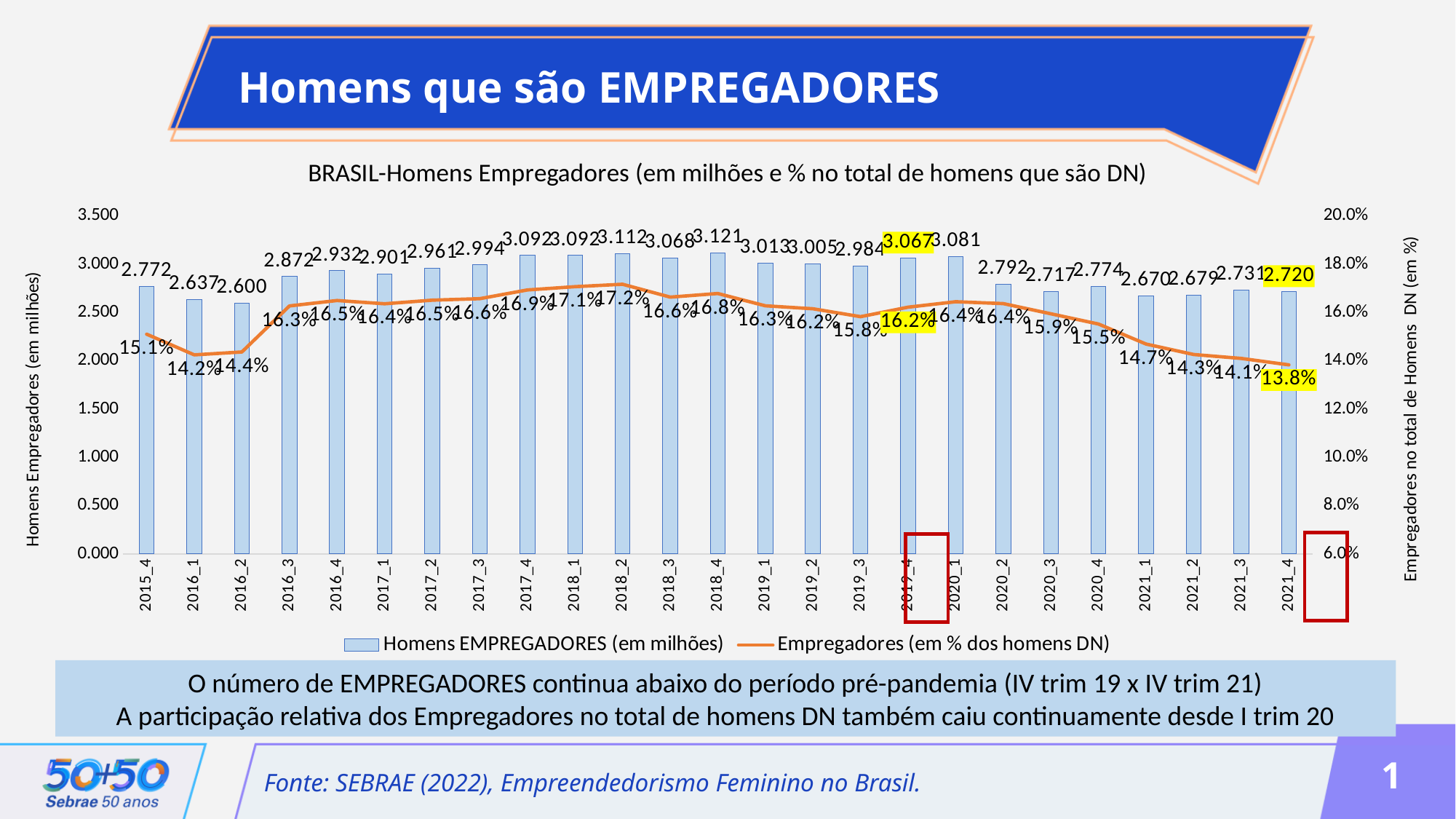
Which quarter has the lowest value of Homens EMPREGADORES (em milhões)? 2016_2 What is the value of Homens EMPREGADORES (em milhões) for 2016_3? 2.872 How many series does the legend list? 2 Which quarter has the highest value of Empregadores (em % dos homens DN)? 2018_2 Which quarter has the highest value of Homens EMPREGADORES (em milhões)? 2018_4 Which quarter has the lowest value of Empregadores (em % dos homens DN)? 2021_4 What is the value of Homens EMPREGADORES (em milhões) for 2021_4? 2.720 What kind of chart is shown on the slide? Combined bar and line chart Which is larger, the Homens EMPREGADORES (em milhões) value for 2020_1 or for 2020_2? 2020_1 How many quarters are shown on the x axis? 25 What is the value of Empregadores (em % dos homens DN) for 2019_4? 16.2% What is the difference in Homens EMPREGADORES (em milhões) between 2019_4 and 2021_4? 0.347